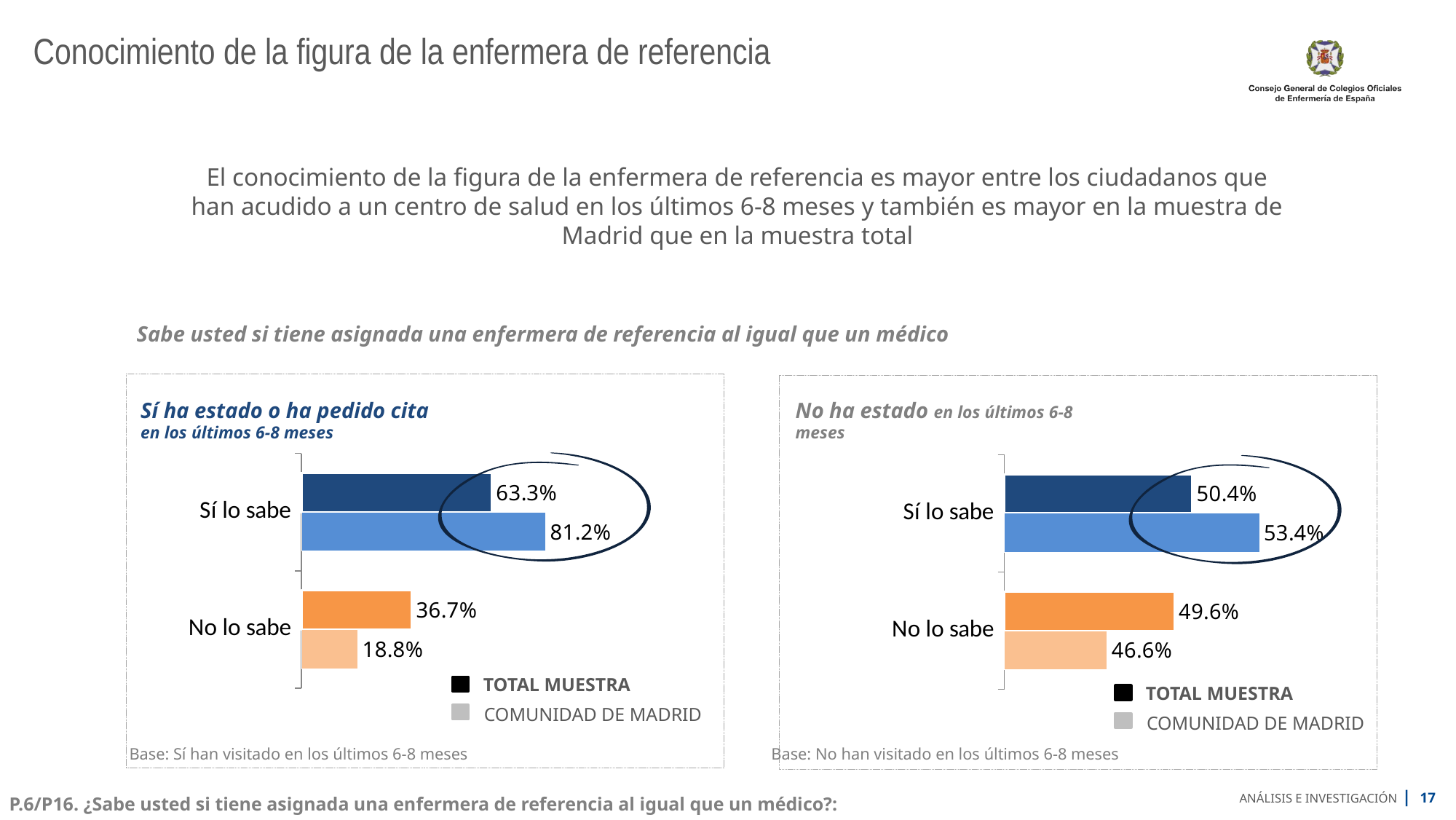
In the left chart (Sí ha estado o ha pedido cita en los últimos 6-8 meses), what is the difference between the COMUNIDAD DE MADRID and TOTAL MUESTRA values for 'Sí lo sabe'? 17.9% What kind of chart is the right chart (No ha estado en los últimos 6-8 meses)? Bar chart In the right chart (No ha estado en los últimos 6-8 meses), what is the difference between the TOTAL MUESTRA values for 'Sí lo sabe' and 'No lo sabe'? 0.8% In the left chart (Sí ha estado o ha pedido cita en los últimos 6-8 meses), what is the value for 'Sí lo sabe' in the COMUNIDAD DE MADRID series? 81.2% In the left chart (Sí ha estado o ha pedido cita en los últimos 6-8 meses), what is the value for 'Sí lo sabe' in the TOTAL MUESTRA series? 63.3% In the right chart (No ha estado en los últimos 6-8 meses), which is larger for 'Sí lo sabe': TOTAL MUESTRA or COMUNIDAD DE MADRID? COMUNIDAD DE MADRID How many categories are shown in the left chart (Sí ha estado o ha pedido cita en los últimos 6-8 meses)? 2 In the right chart (No ha estado en los últimos 6-8 meses), what is the value for 'No lo sabe' in the COMUNIDAD DE MADRID series? 46.6% In the right chart (No ha estado en los últimos 6-8 meses), what is the value for 'Sí lo sabe' in the TOTAL MUESTRA series? 50.4% In the left chart (Sí ha estado o ha pedido cita en los últimos 6-8 meses), what is the value for 'No lo sabe' in the COMUNIDAD DE MADRID series? 18.8% How many series does the legend of the left chart list? 2 In the left chart (Sí ha estado o ha pedido cita en los últimos 6-8 meses), which series has the highest value for 'No lo sabe'? TOTAL MUESTRA